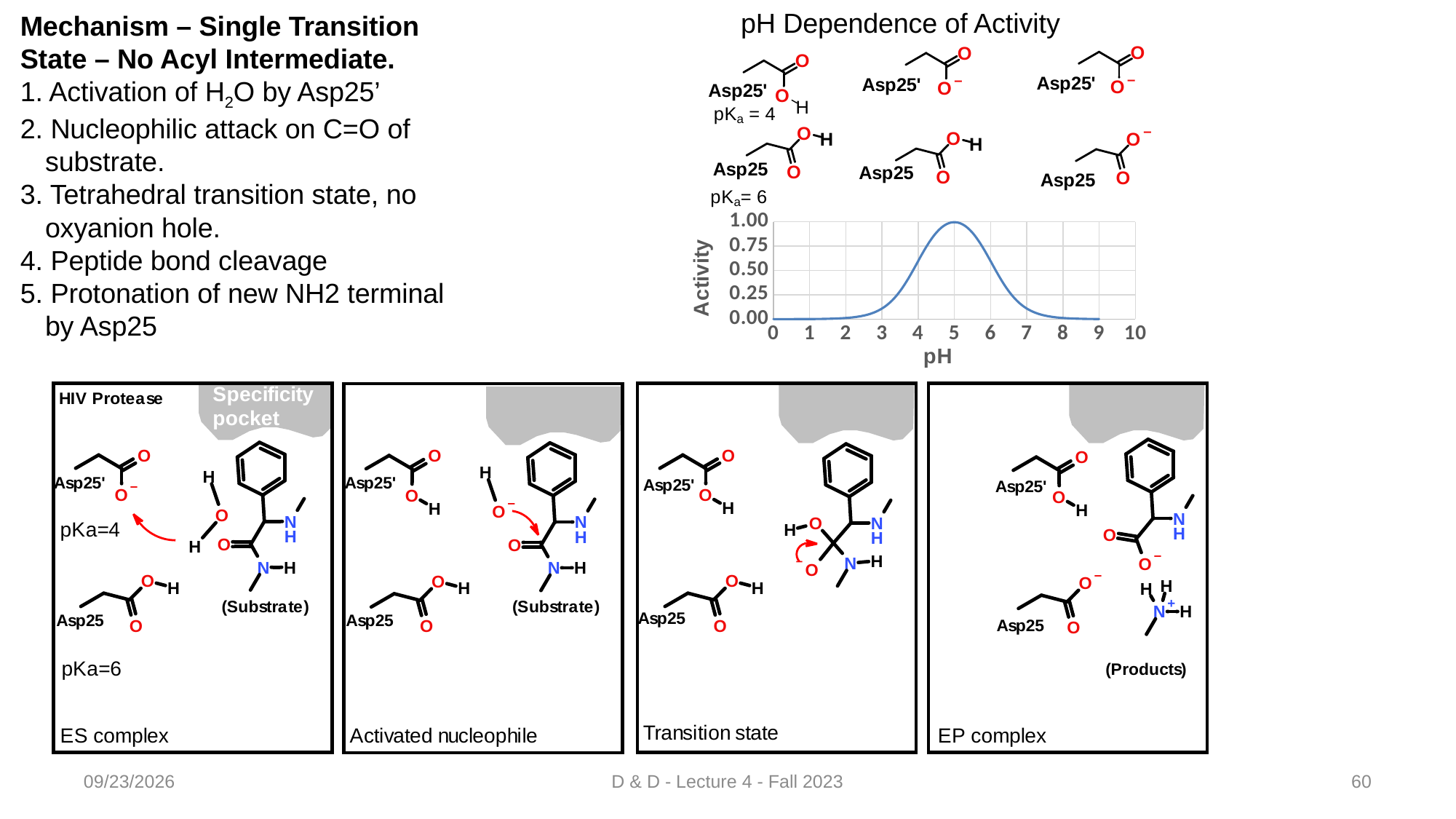
Is the activity at pH 3 greater or less than 0.25? less Does the activity rise or fall as pH increases from 2 to 5? rise At which pH value does the activity curve reach its highest point? 5 What is the label of the x axis of the chart? pH How many lines are plotted on the activity chart? 1 Is the activity at pH 7 greater or less than 0.25? less Is the activity at pH 5 greater or less than 0.75? greater What kind of chart is shown under the title "pH Dependence of Activity"? line chart Which has the higher activity, pH 3 or pH 5? pH 5 What is the title of the chart on the slide? pH Dependence of Activity Does the activity rise or fall as pH increases from 5 to 9? fall